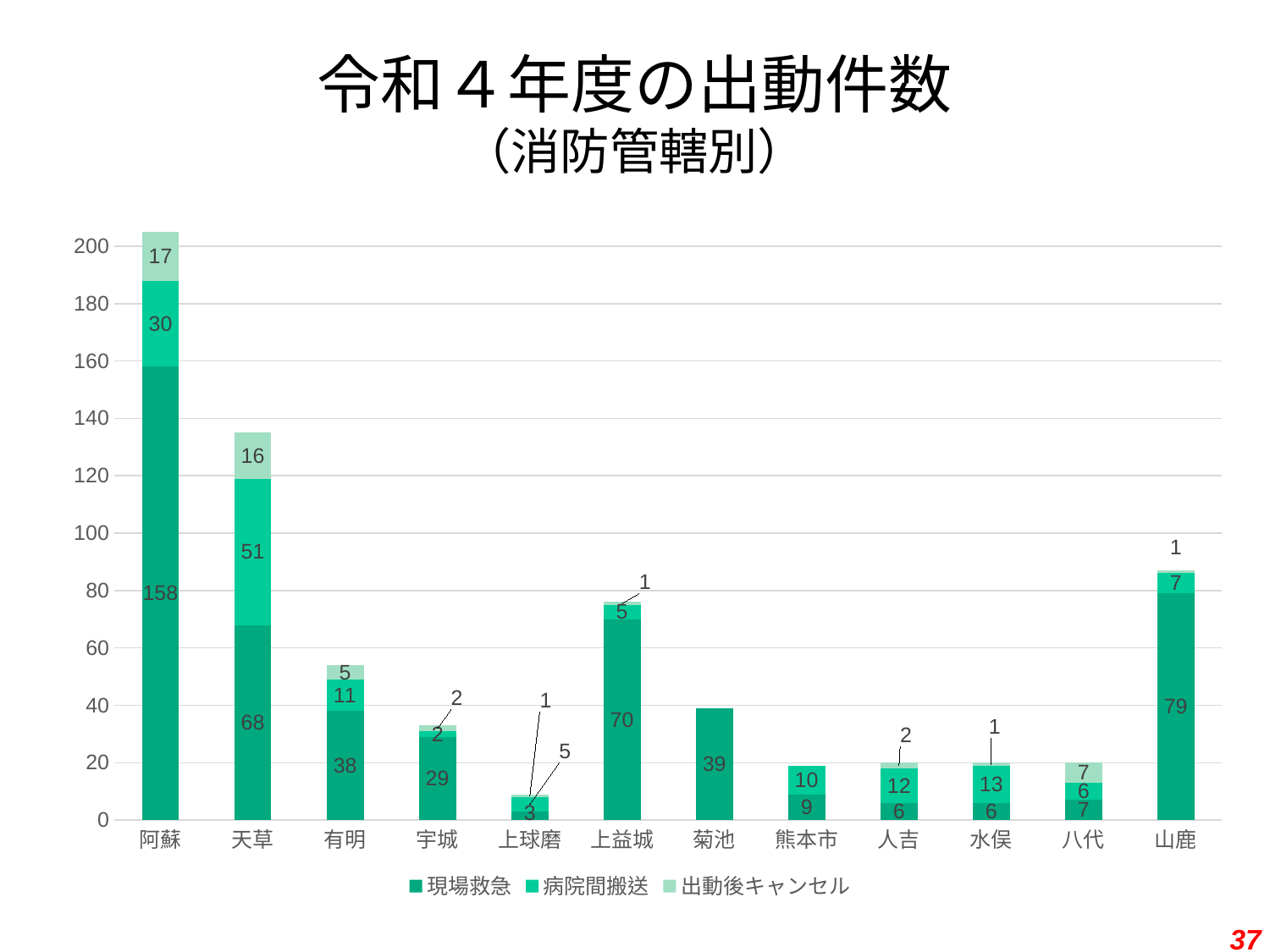
Which category has the lowest 現場救急 value? 上球磨 What is the 病院間搬送 value for 天草? 51 Which category has the highest 現場救急 value? 阿蘇 Which is larger, the 病院間搬送 value for 水俣 or for 人吉? 水俣 What is the difference between the 現場救急 values for 阿蘇 and 天草? 90 What is the 現場救急 value for 阿蘇? 158 How many categories are shown on the x axis? 12 What kind of chart is shown on the slide? Stacked bar chart What is the total of the stacked bar for 天草? 135 How many series does the legend list? 3 What is the 出動後キャンセル value for 八代? 7 What is the total of the stacked bar for 山鹿? 87